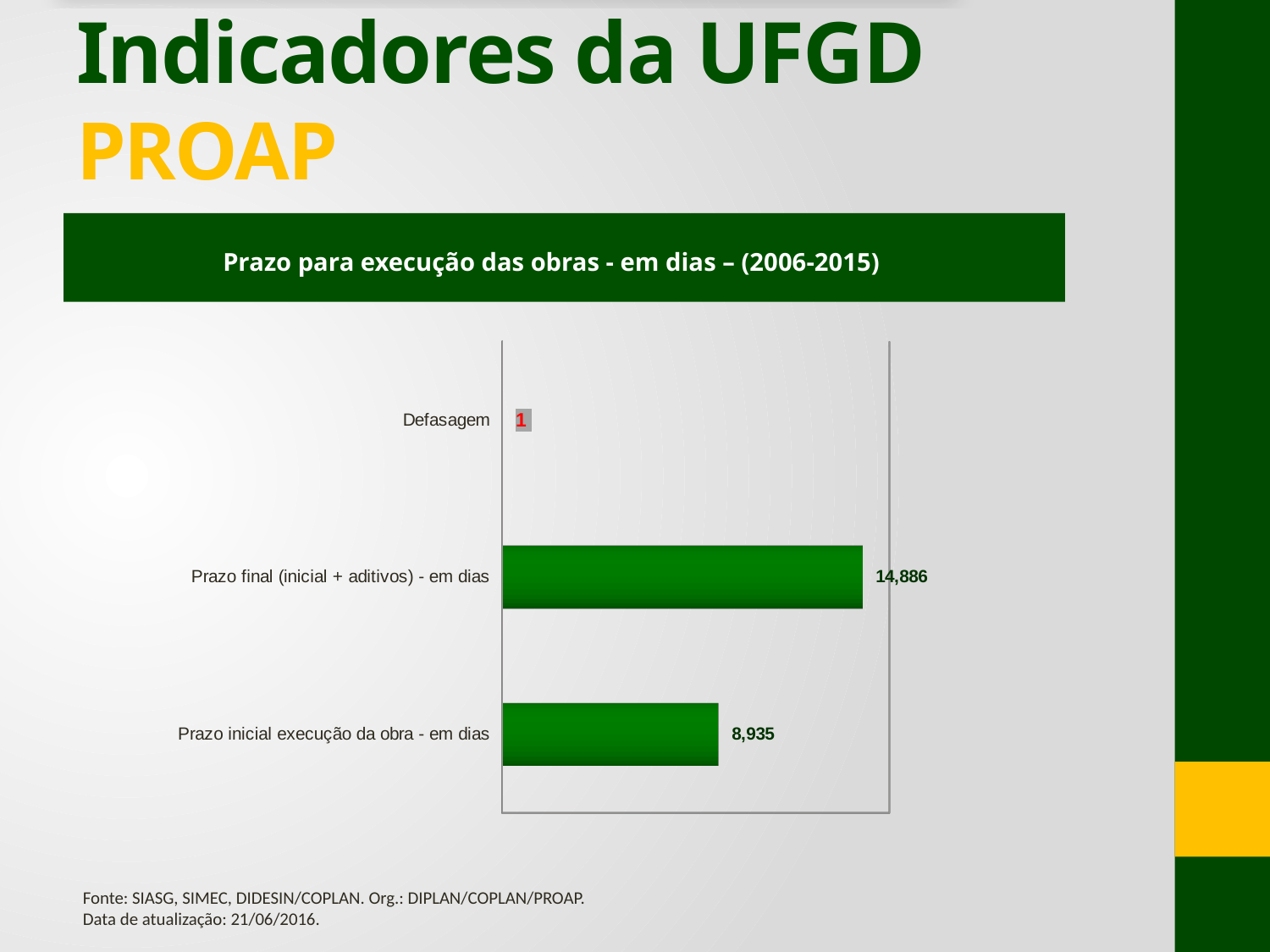
Which is larger: "Prazo final (inicial + aditivos) - em dias" or "Prazo inicial execução da obra - em dias"? Prazo final (inicial + aditivos) - em dias Which category has the highest value? Prazo final (inicial + aditivos) - em dias What is the title of the chart? Prazo para execução das obras - em dias – (2006-2015) What is the difference between "Prazo final (inicial + aditivos) - em dias" and "Prazo inicial execução da obra - em dias"? 5,951 What kind of chart is shown on the slide? Bar chart What value is labelled on the "Defasagem" bar? 1 Which category has the lowest value? Defasagem What is the value for "Prazo final (inicial + aditivos) - em dias"? 14,886 What colour are the bars in the chart? Green What is the value for "Prazo inicial execução da obra - em dias"? 8,935 How many categories are shown in the chart? 3